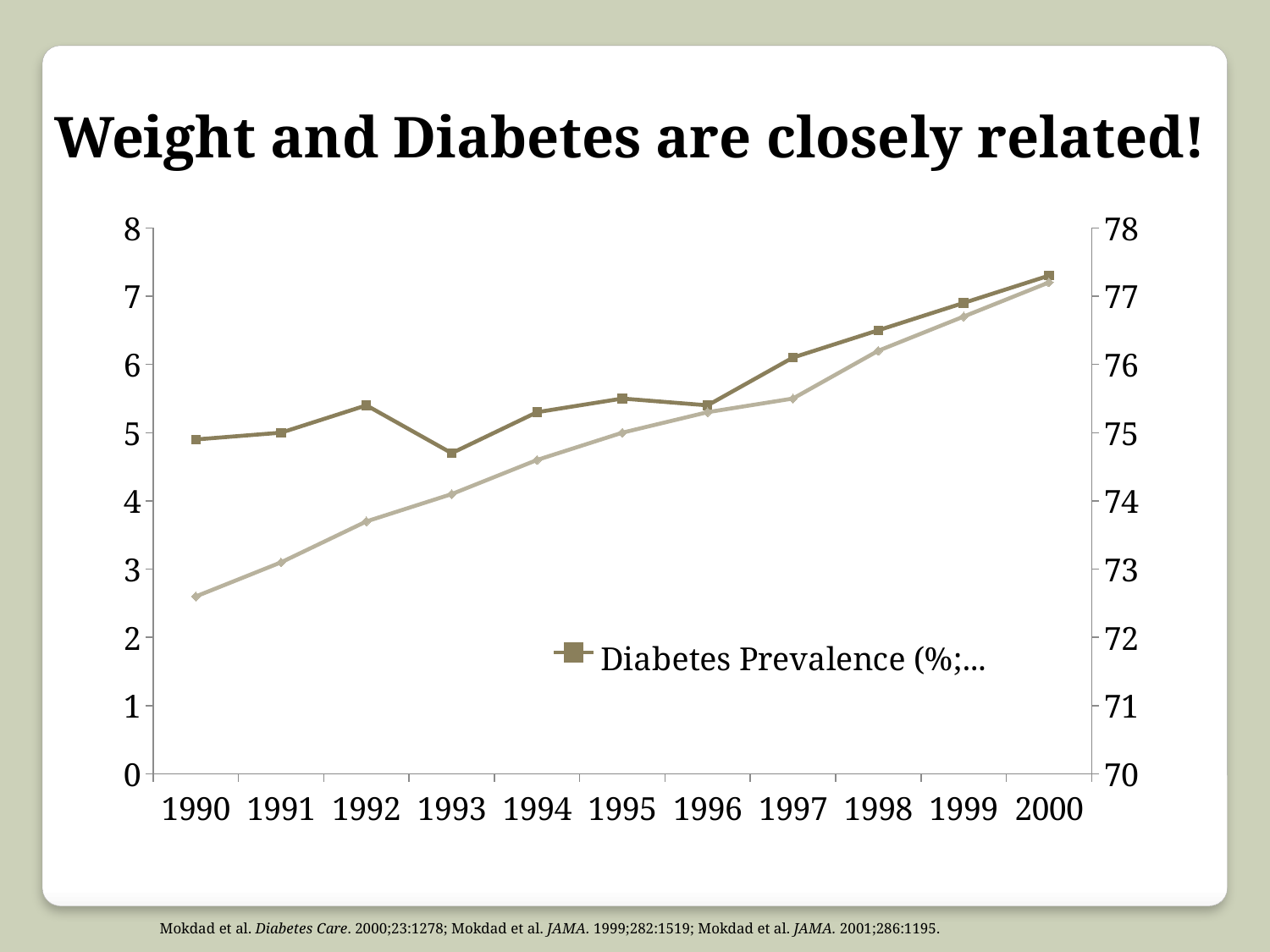
In which year does the Diabetes Prevalence line reach its highest point? 2000 What is the name of the series shown in the legend? Diabetes Prevalence (%;... In which year does the Diabetes Prevalence line reach its lowest point? 1993 Is the Diabetes Prevalence value for 1990 greater or less than 4 on the left axis? greater Is the Diabetes Prevalence value for 1993 greater or less than 5 on the left axis? less How many years are plotted along the x axis of the chart? 11 What kind of chart is shown on the slide? line chart Is the Diabetes Prevalence value for 2000 greater or less than 7 on the left axis? greater How many series entries are visible in the chart's legend? 1 Which year has the larger Diabetes Prevalence value, 1992 or 1993? 1992 What is the title of the slide containing the chart? Weight and Diabetes are closely related! Does the Diabetes Prevalence line generally rise or fall from 1990 to 2000? rise